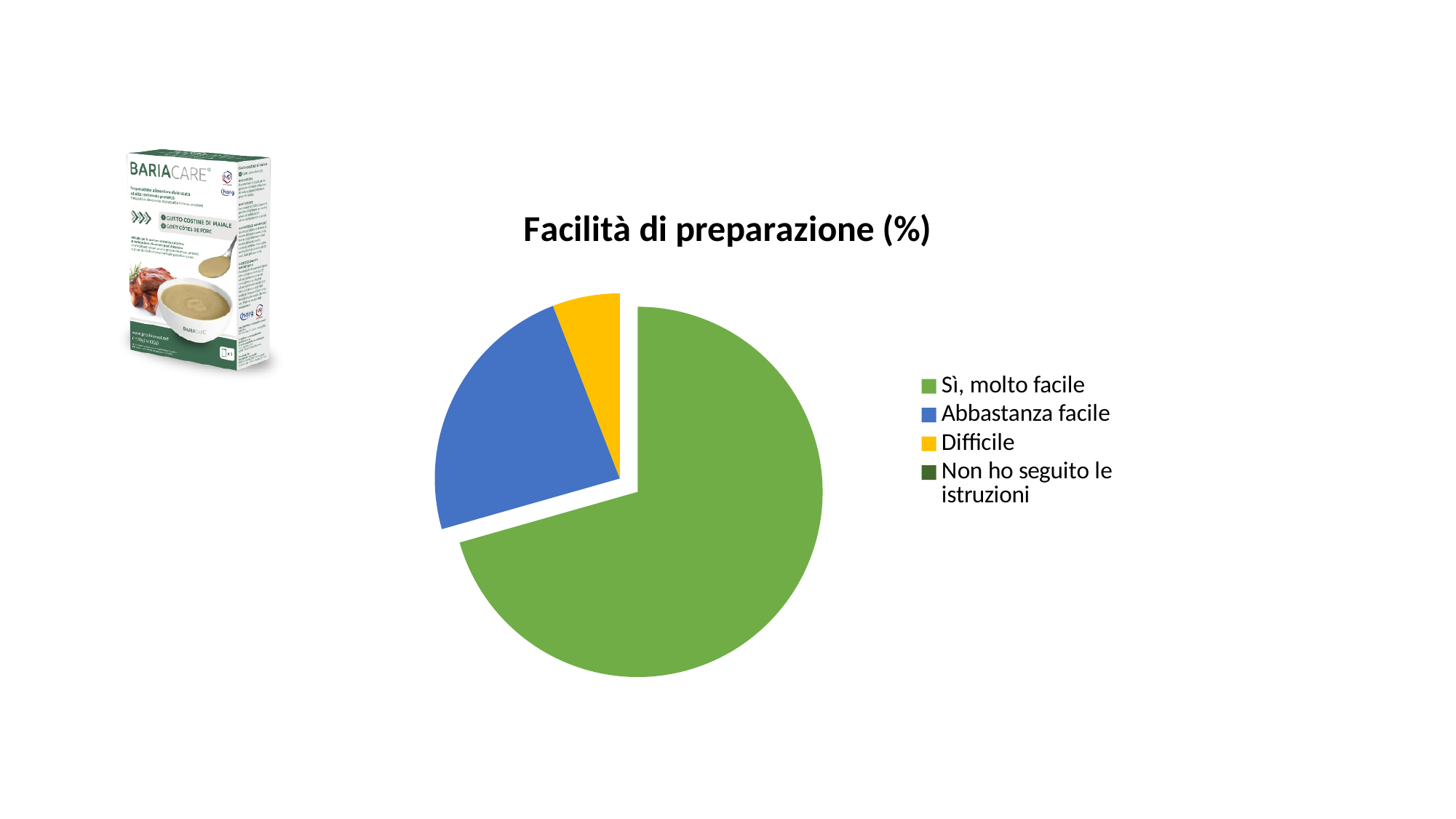
Which slice is larger, "Sì, molto facile" or "Abbastanza facile"? Sì, molto facile What kind of chart is shown on the slide? Pie chart What is the title of the chart? Facilità di preparazione (%) Which of the visible slices is the smallest? Difficile Which colour represents "Difficile" in the chart? Yellow Does the "Sì, molto facile" slice account for more or less than half of the pie? More Which slice is larger, "Abbastanza facile" or "Difficile"? Abbastanza facile Which category has the largest slice of the pie? Sì, molto facile How many entries does the chart's legend list? 4